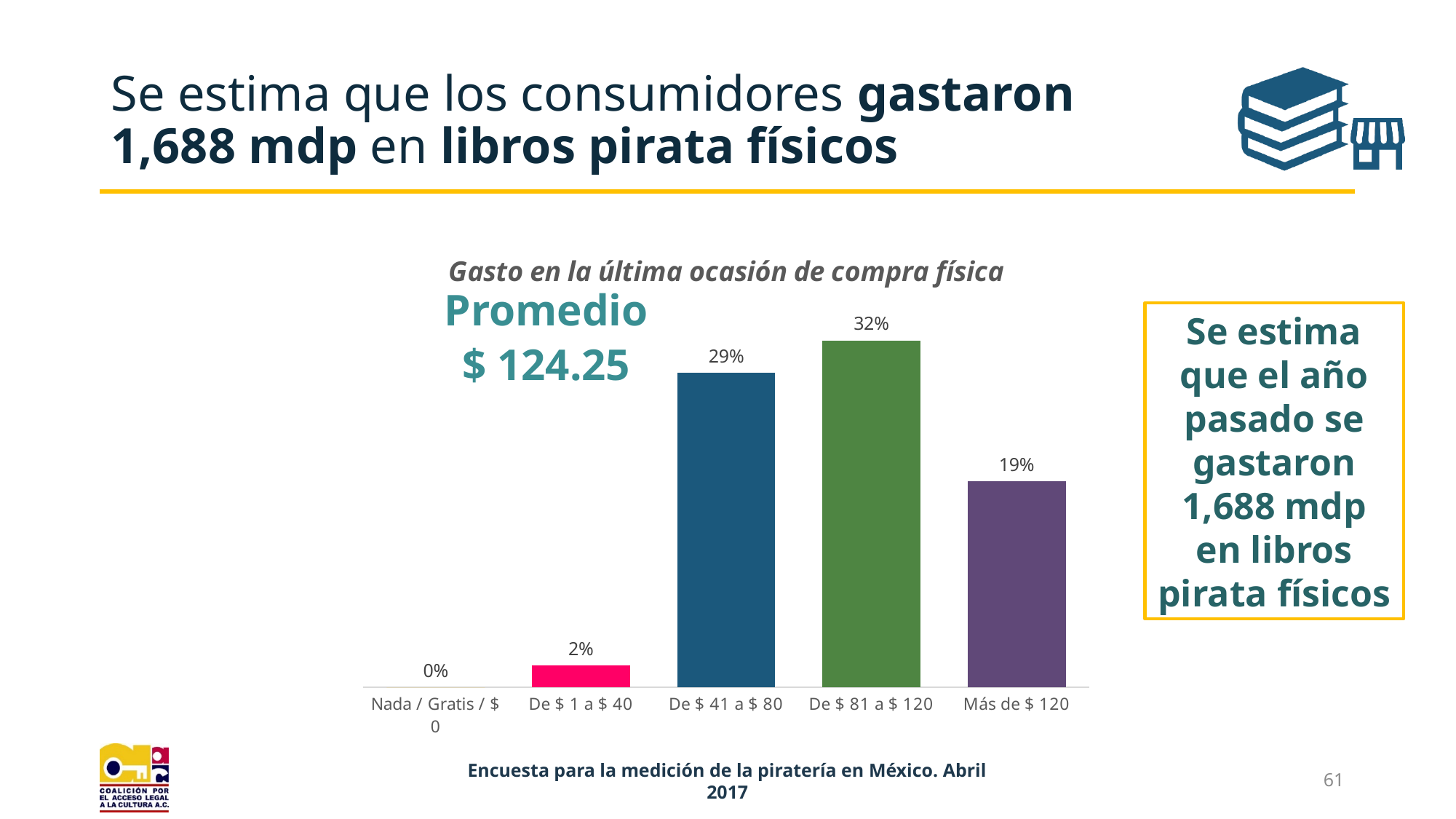
What is the value for the 'De $ 41 a $ 80' category? 29% Which category has the lowest value? Nada / Gratis / $ 0 Which category has the highest value? De $ 81 a $ 120 Which is larger, the value for 'De $ 41 a $ 80' or the value for 'Más de $ 120'? De $ 41 a $ 80 What is the value for the 'Más de $ 120' category? 19% What kind of chart is shown on the slide? Bar chart What is the difference between the values for 'De $ 81 a $ 120' and 'Más de $ 120'? 13% What is the value for the 'De $ 1 a $ 40' category? 2% What is the value for the 'De $ 81 a $ 120' category? 32% What is the title of the chart? Gasto en la última ocasión de compra física What average (Promedio) value is shown next to the chart? $ 124.25 How many categories are shown on the x axis of the chart? 5